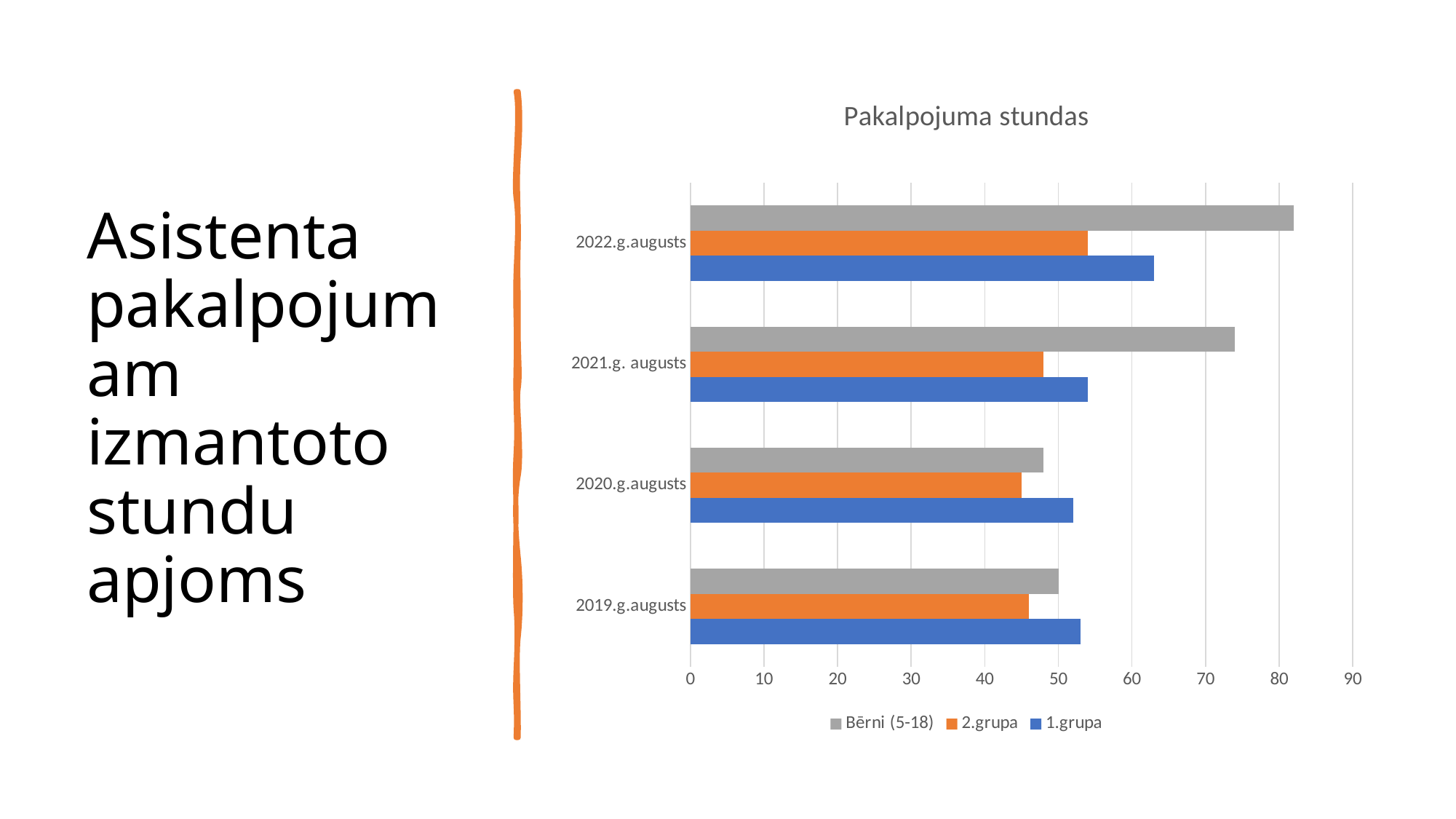
Which colour represents the 2.grupa series? orange In 2022.g.augusts, which is larger: Bērni (5-18) or 1.grupa? Bērni (5-18) Which category has the highest value for Bērni (5-18)? 2022.g.augusts What is the title of the chart? Pakalpojuma stundas How many categories (time periods) are shown on the chart? 4 Is the value for Bērni (5-18) in 2021.g. augusts greater or less than 70? greater Is the value for 1.grupa in 2022.g.augusts greater or less than 60? greater Is the value for 2.grupa in 2020.g.augusts greater or less than 50? less In 2021.g. augusts, which is larger: 1.grupa or 2.grupa? 1.grupa What kind of chart is shown on the slide? bar chart How many series does the legend list? 3